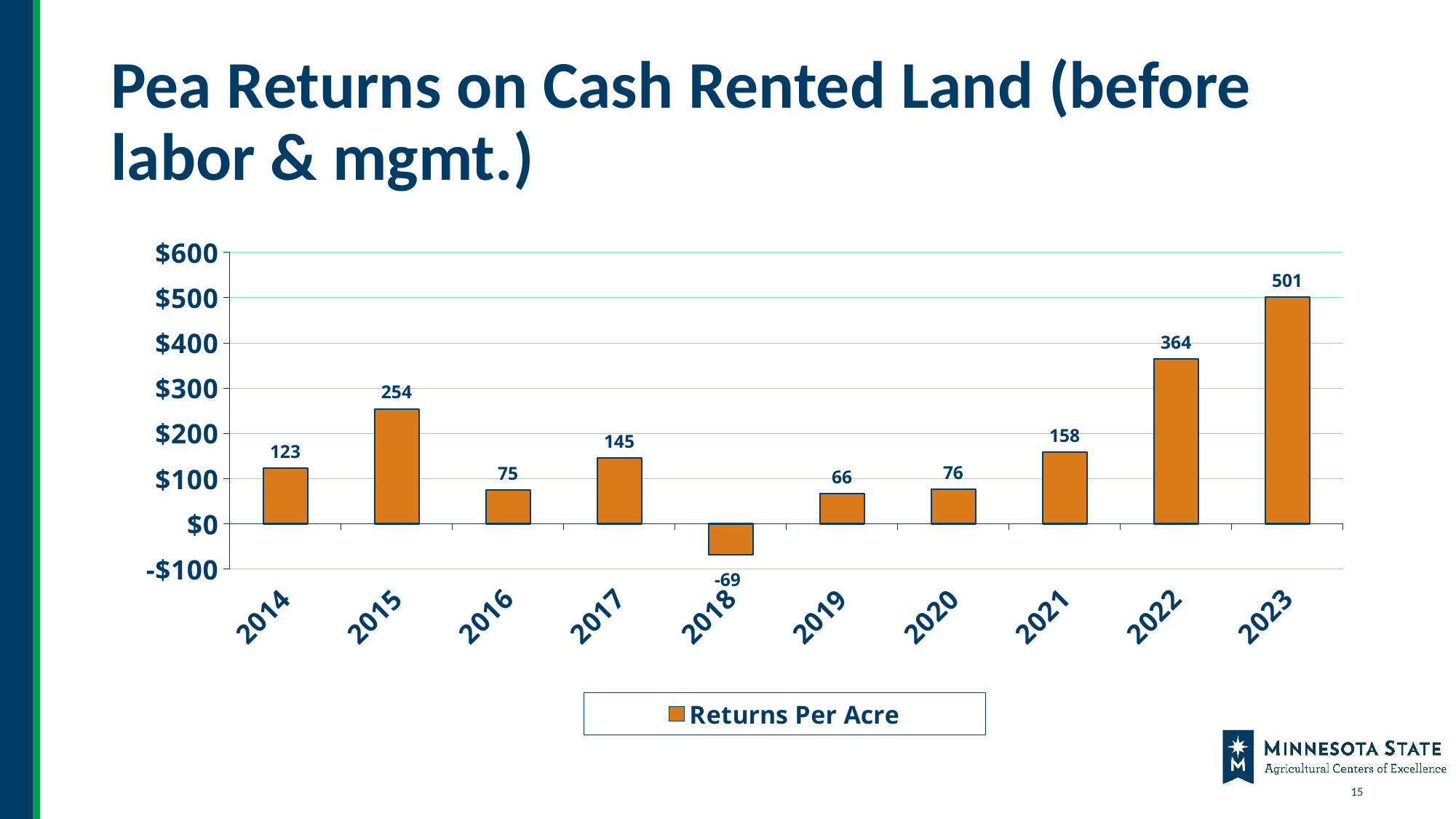
How many series does the legend list? 1 Which year has a larger Returns Per Acre, 2017 or 2021? 2021 Which year has the highest Returns Per Acre? 2023 How many years are shown on the x axis? 10 Is the value for 2022 greater or less than $300? greater What is the value for Returns Per Acre in 2023? 501 What kind of chart is shown on the slide? bar chart What is the value for Returns Per Acre in 2015? 254 What is the value for Returns Per Acre in 2018? -69 What is the difference between Returns Per Acre in 2023 and 2022? 137 Do the Returns Per Acre values rise or fall from 2020 to 2023? rise Which year has the lowest Returns Per Acre? 2018